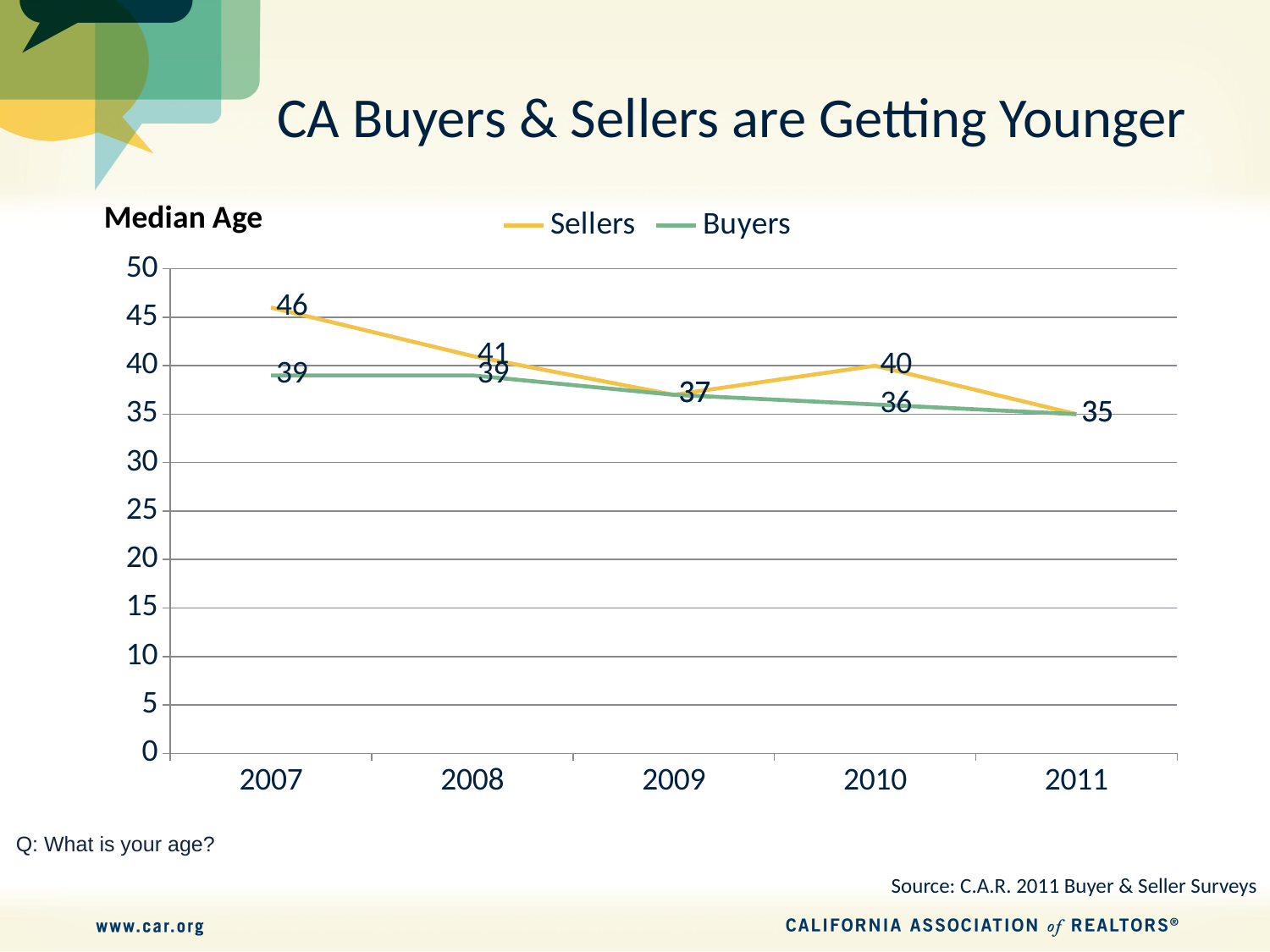
How many years are shown on the x axis? 5 How many series does the legend list? 2 What is the median age of Sellers in 2010? 40 What is the difference between the Sellers and Buyers median age in 2010? 4 In which year is the Sellers median age lowest? 2011 What is the median age of Buyers in 2008? 39 What kind of chart is shown on the slide? Line chart In which year is the Sellers median age highest? 2007 In 2008, which series has the higher median age, Sellers or Buyers? Sellers By how much did the Sellers median age fall from 2007 to 2011? 11 What is the median age of Sellers in 2007? 46 What is the median age of Buyers in 2010? 36